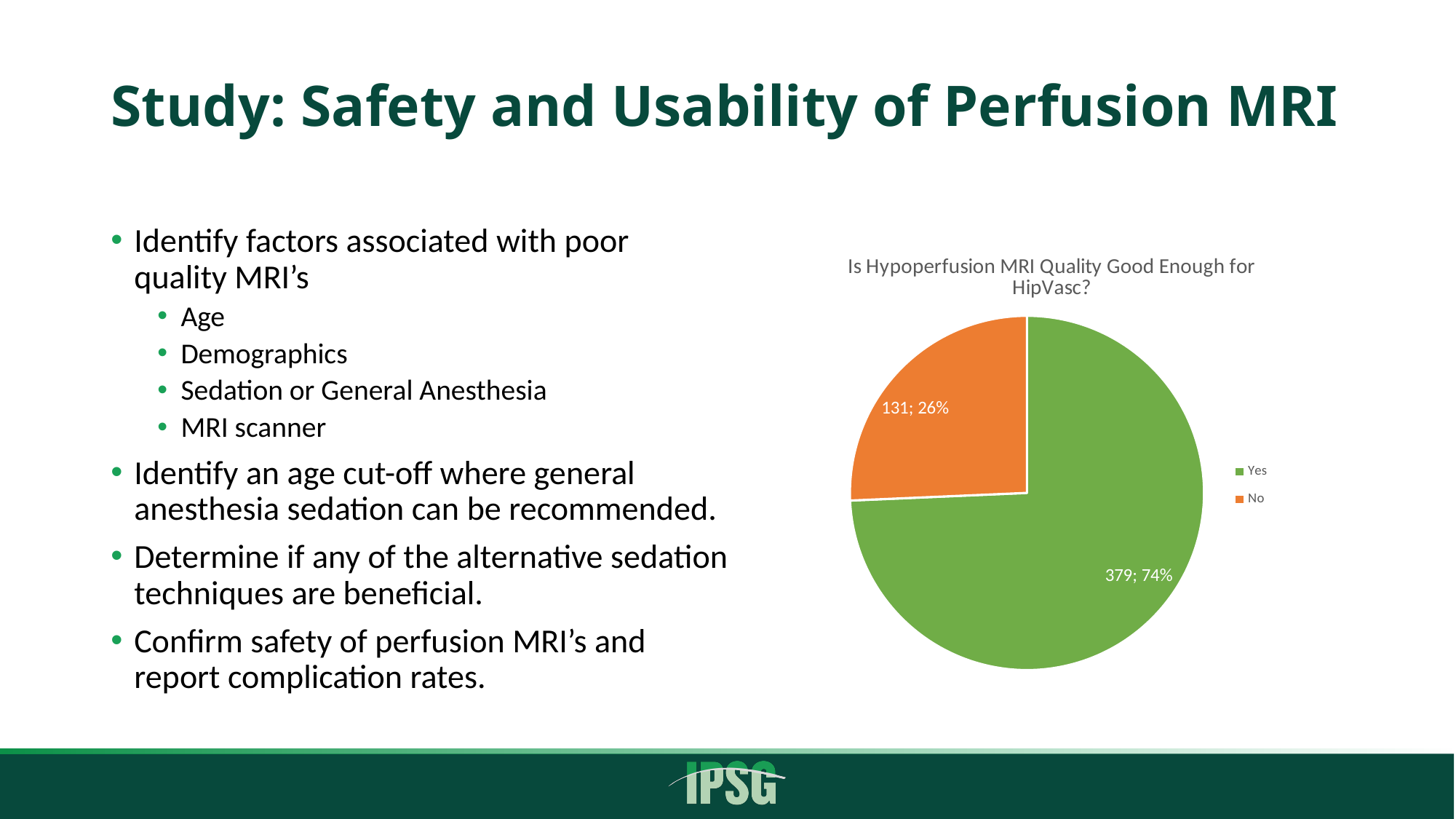
What is the title of the chart? Is Hypoperfusion MRI Quality Good Enough for HipVasc? What is the count for the "Yes" slice? 379 What is the total count across both slices? 510 How many slices does the pie chart have? 2 What colour is the "No" slice? orange What percentage share does the "Yes" slice represent? 74% What percentage share does the "No" slice represent? 26% What is the count for the "No" slice? 131 Which slice is the smallest? No What is the difference in count between the "Yes" and "No" slices? 248 What type of chart is shown on the slide? pie chart Which slice is the largest? Yes